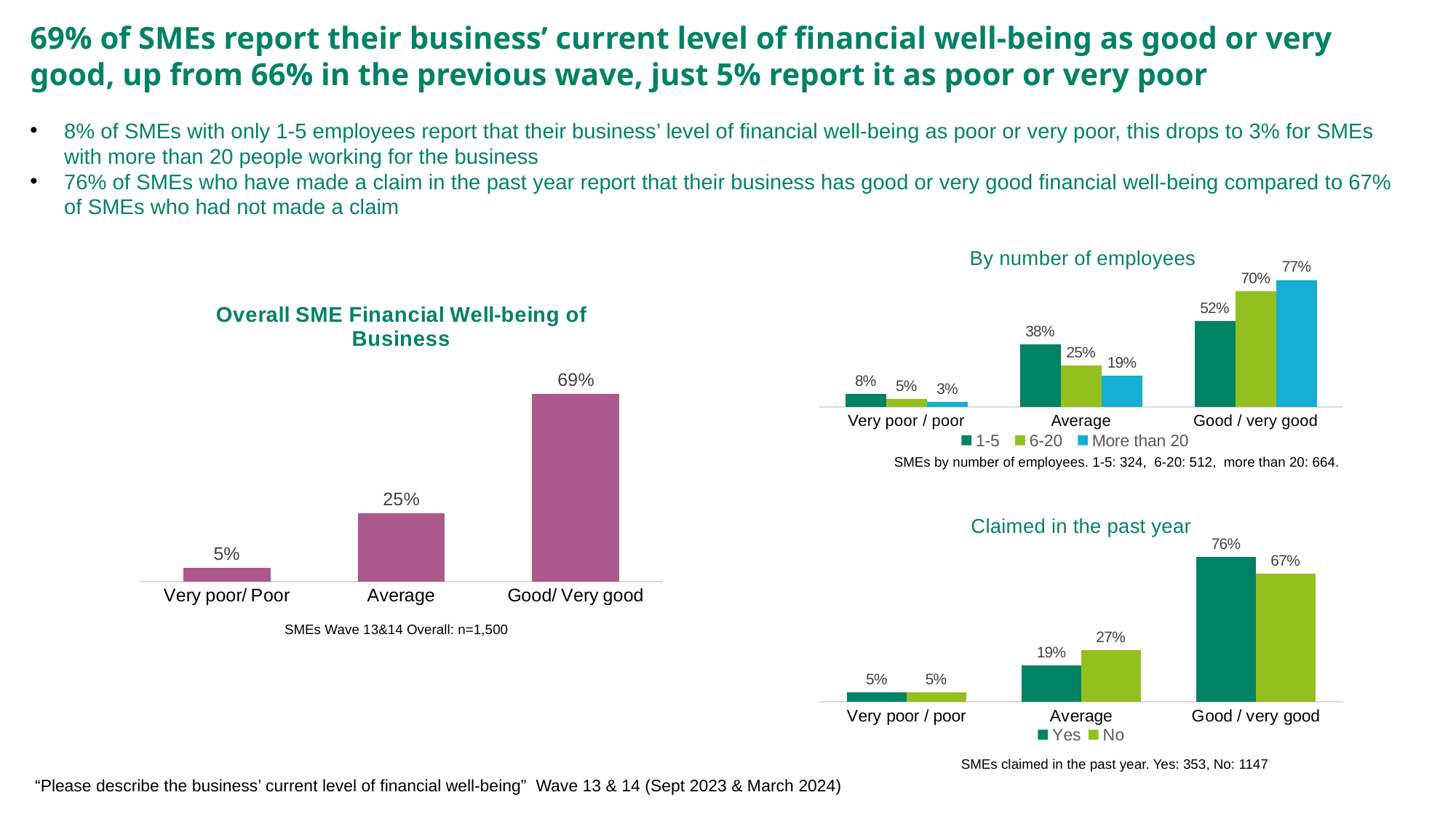
In the 'Claimed in the past year' chart, what is the value for No in the Average category? 27% In the 'Overall SME Financial Well-being of Business' chart, which category has the lowest value? Very poor/ Poor In the 'Overall SME Financial Well-being of Business' chart, what is the value for Good/ Very good? 69% In the 'By number of employees' chart, what is the difference between the More than 20 and 1-5 values for Good / very good? 25% What kind of chart is the 'By number of employees' chart? Bar chart In the 'Overall SME Financial Well-being of Business' chart, how many categories are shown? 3 In the 'Claimed in the past year' chart, which is larger for Good / very good: Yes or No? Yes In the 'By number of employees' chart, what is the value for the 1-5 series in the Average category? 38% In the 'By number of employees' chart, how many series does the legend list? 3 In the 'By number of employees' chart, which series has the highest value in the Good / very good category? More than 20 In the 'Overall SME Financial Well-being of Business' chart, what is the difference between the Good/ Very good and Average values? 44% In the 'Claimed in the past year' chart, what are the two series listed in the legend? Yes and No